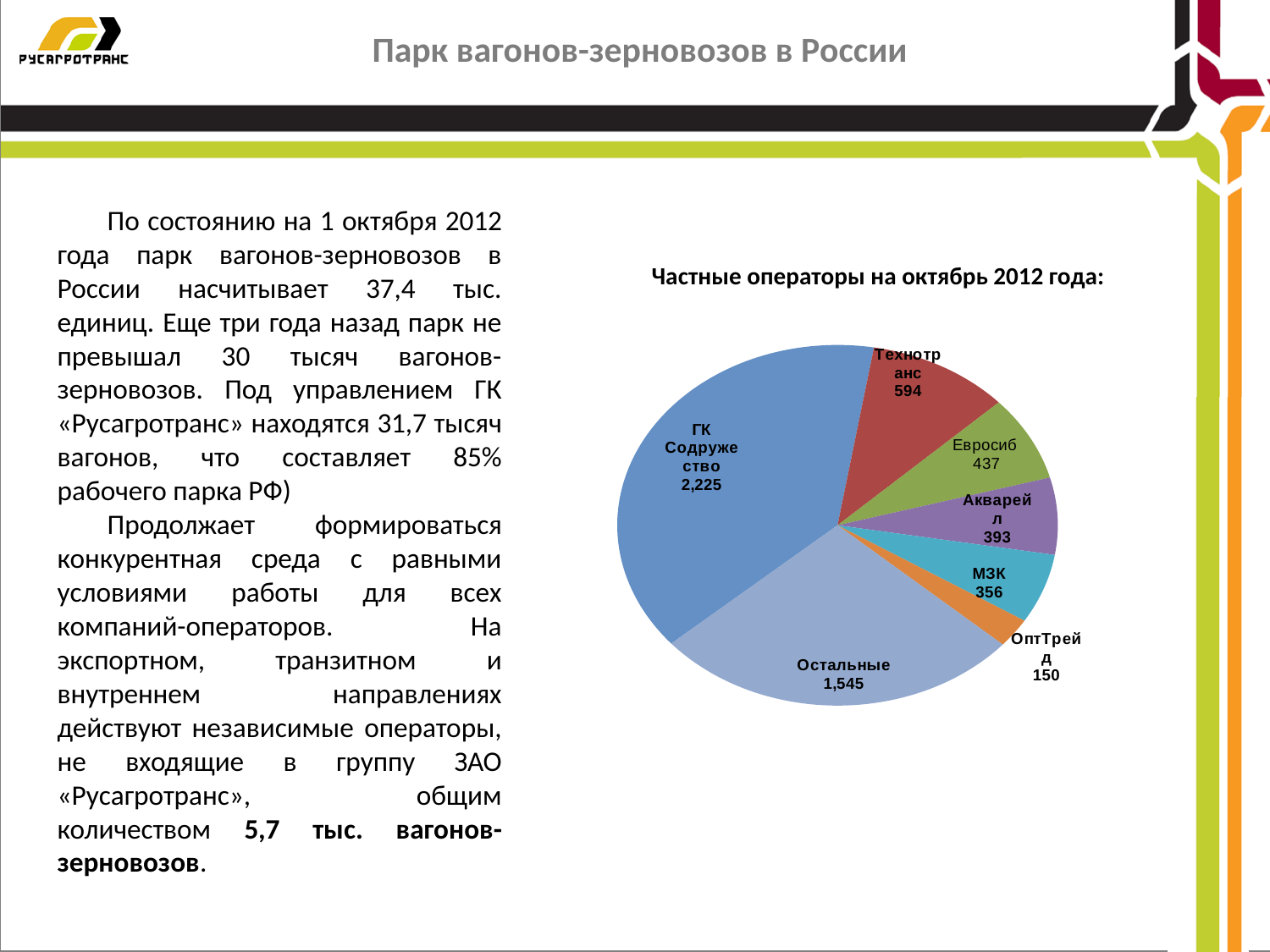
What is the value for ОптТрейд? 150 What is the total of all slices in the pie chart? 5,700 Which category has the largest slice? ГК Содружество How many slices does the pie chart have? 7 What is the chart's title? Частные операторы на октябрь 2012 года: Which is larger, the value for Технотранс or the value for Остальные? Остальные What kind of chart is shown on the slide? pie chart What is the value for ГК Содружество? 2,225 What is the value for Евросиб? 437 What is the value for Технотранс? 594 What is the difference between the values for Акварейл and МЗК? 37 Which category has the smallest slice? ОптТрейд